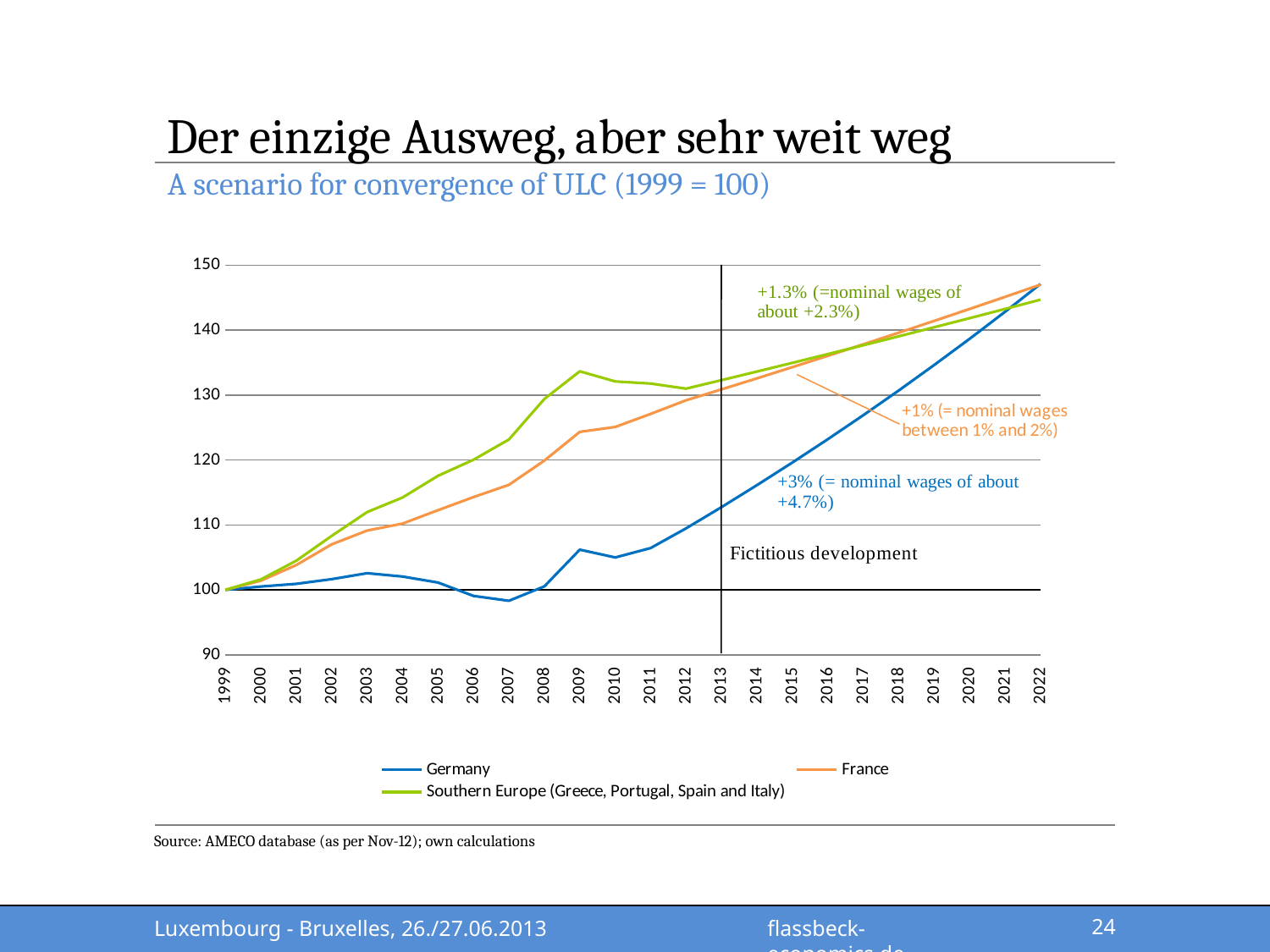
Is the value for Germany in 2007 greater or less than 100? less Which series has the highest value in 2009? Southern Europe (Greece, Portugal, Spain and Italy) What kind of chart is shown on the slide? line chart How many years are shown on the x axis? 24 In 2009, which is larger: the value for France or the value for Germany? France How many series does the legend list? 3 What is the index value for Germany in 1999? 100 Is the value for Southern Europe (Greece, Portugal, Spain and Italy) in 2009 greater or less than 130? greater What annual growth rate does the annotation give for the Germany line after 2013? +3% Is the value for Germany in 2022 greater or less than 140? greater Which series has the lowest value in 2012? Germany Does the Germany line rise or fall from 2013 to 2022? rise